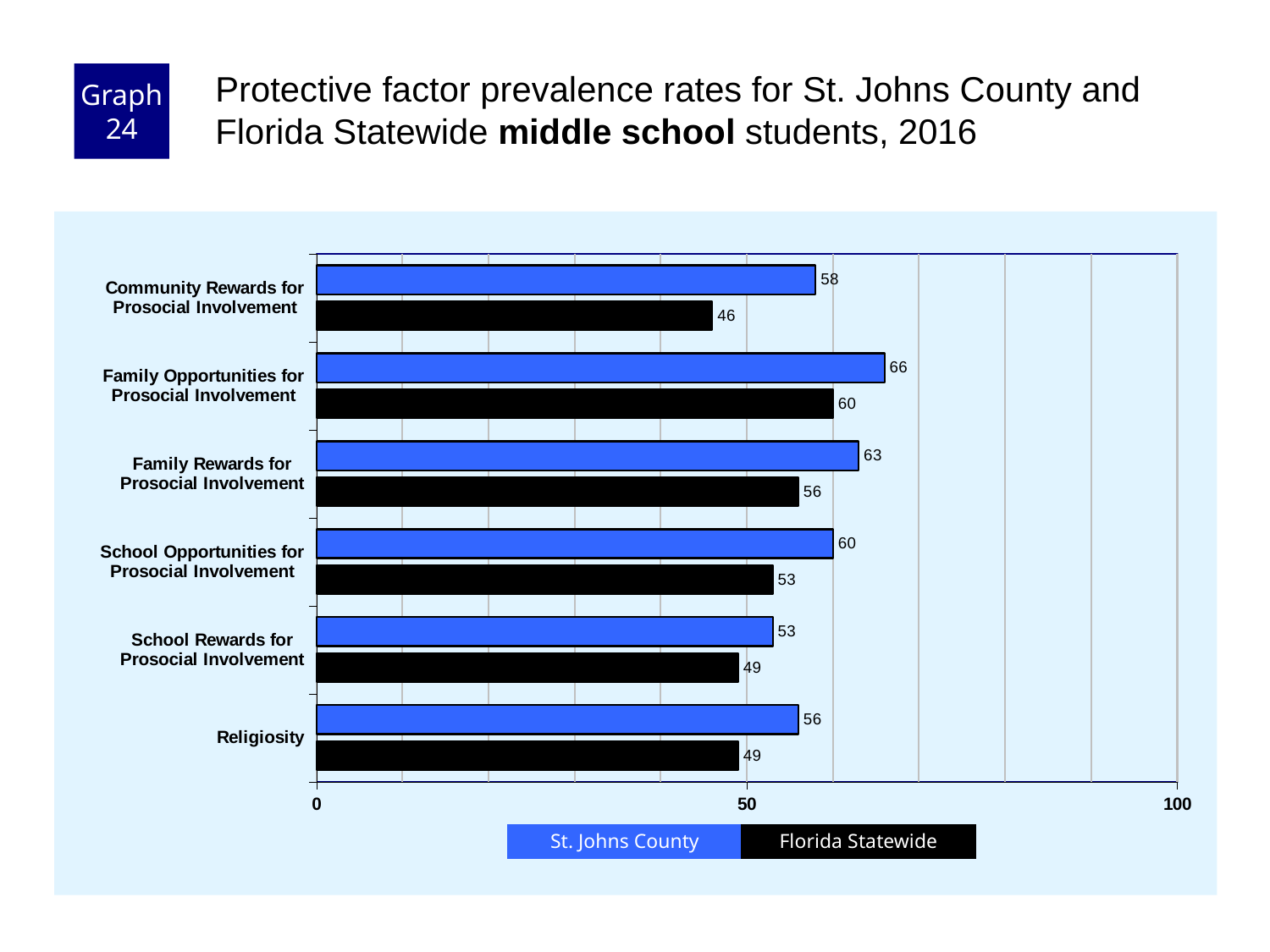
Which is larger: the St. Johns County value for Family Rewards for Prosocial Involvement or the St. Johns County value for School Opportunities for Prosocial Involvement? Family Rewards for Prosocial Involvement Which category has the lowest Florida Statewide value? Community Rewards for Prosocial Involvement What is the Florida Statewide value for Community Rewards for Prosocial Involvement? 46 What is the difference between the St. Johns County and Florida Statewide values for Community Rewards for Prosocial Involvement? 12 How many series does the legend list? 2 How many protective factor categories are shown on the chart? 6 Which category has the highest St. Johns County value? Family Opportunities for Prosocial Involvement What type of chart is shown on the slide? Bar chart What is the Florida Statewide value for Religiosity? 49 What is the St. Johns County value for Family Opportunities for Prosocial Involvement? 66 What is the difference between the St. Johns County and Florida Statewide values for School Rewards for Prosocial Involvement? 4 Is the Florida Statewide value for Community Rewards for Prosocial Involvement greater or less than 50? less